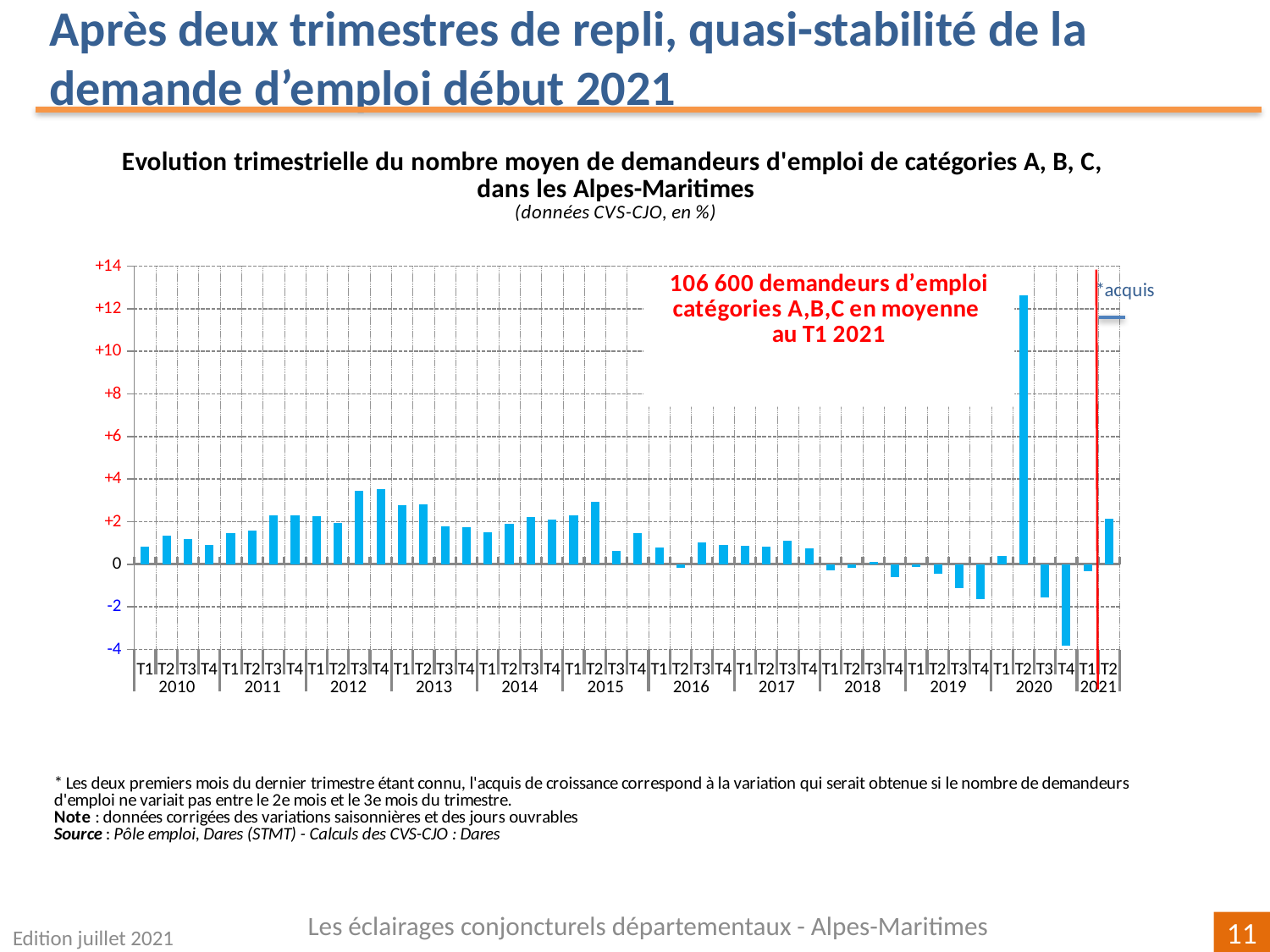
Is the value for T1 2010 greater or less than +2? less Is the value for T4 2020 greater or less than -2? less What kind of chart is shown on the slide? bar chart Which quarter has the lowest value on the chart? T4 2020 Which quarter has the highest value on the chart? T2 2020 Which is larger, the value for T2 2020 or the value for T4 2020? T2 2020 How many years are labelled on the x axis of the chart? 12 Do the values rise or fall across the four quarters of 2019? fall Which is larger, the value for T3 2012 or the value for T1 2016? T3 2012 Is the value for T3 2012 greater or less than +2? greater According to the annotation on the chart, how many demandeurs d'emploi catégories A,B,C were there on average in T1 2021? 106 600